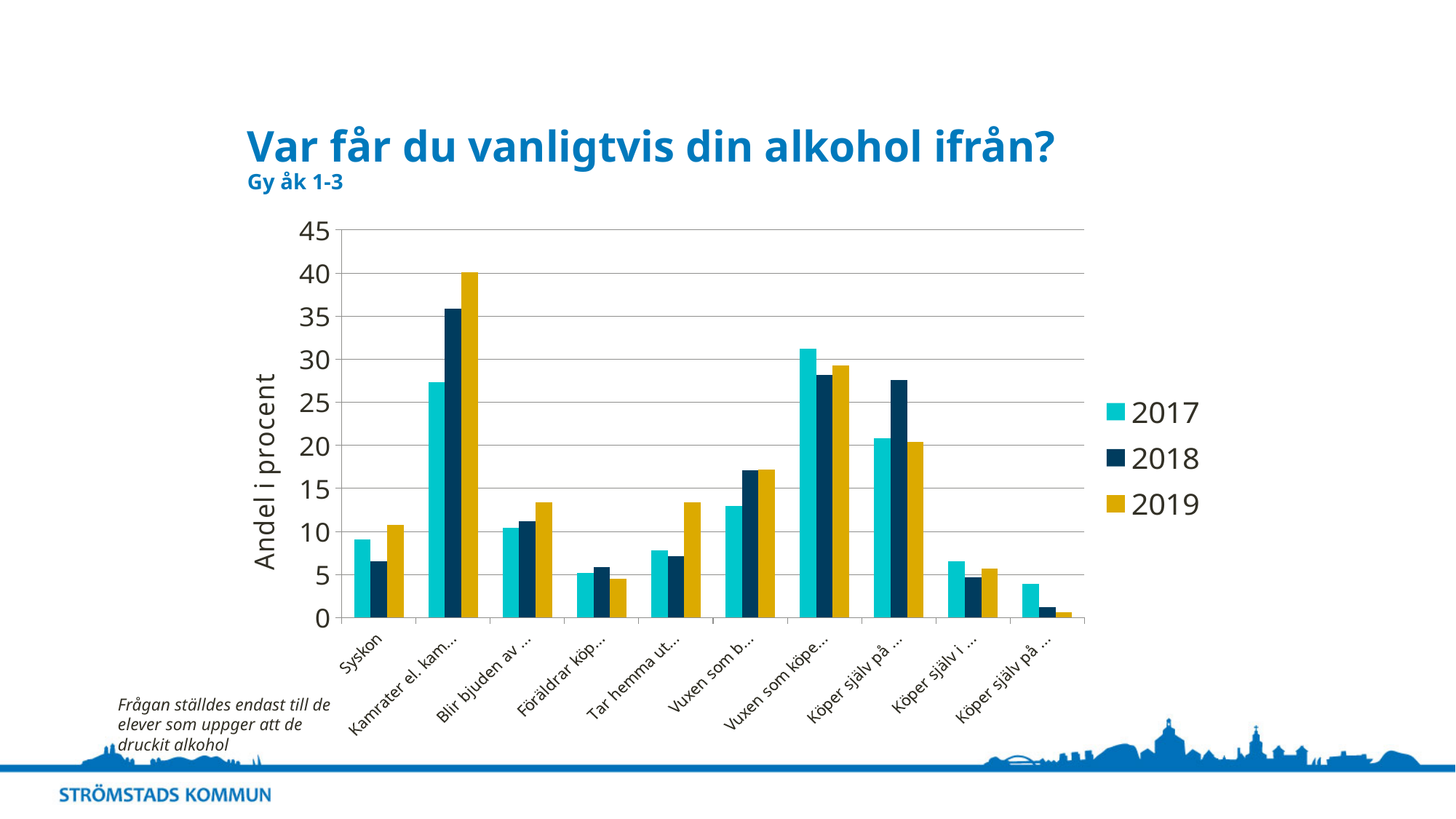
How many series does the legend list? 3 What is the label on the y axis? Andel i procent For Syskon, is the value for 2017 or 2018 larger? 2017 Is the tallest bar on the chart greater or less than 35? greater What is the title of the chart? Var får du vanligtvis din alkohol ifrån? Which series contains the tallest bar on the chart? 2019 How many categories are shown along the x axis? 10 Which year has the highest value for Syskon? 2019 Is the value for Syskon in 2019 greater or less than 10? greater Is the value for Syskon in 2018 greater or less than 10? less Which year has the lowest value for Syskon? 2018 What kind of chart is shown on the slide? bar chart